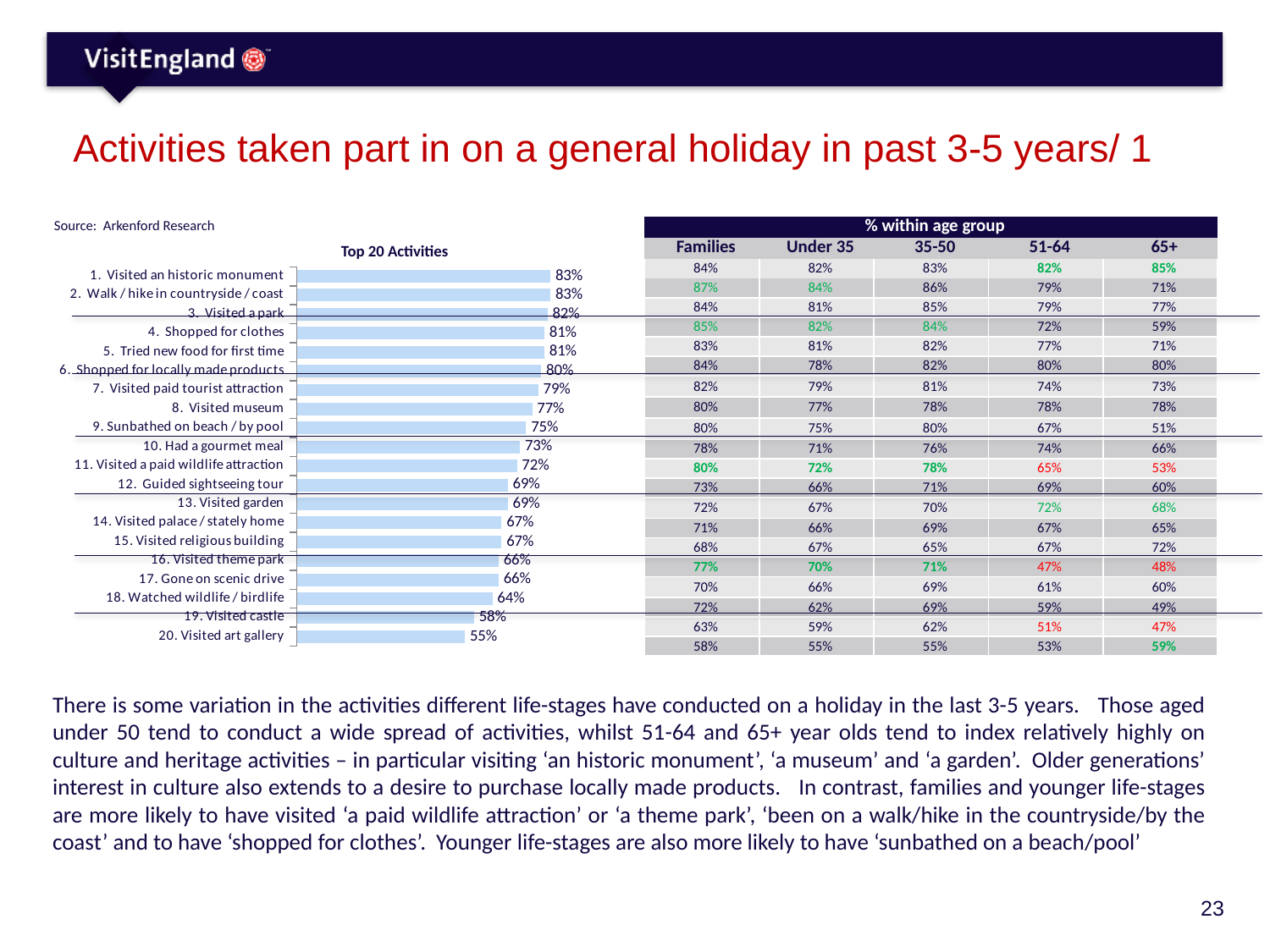
Do the values in the Top 20 Activities chart rise or fall going down the list from activity 1 to activity 20? fall How many activities are plotted in the Top 20 Activities chart? 20 In the Top 20 Activities chart, what is the value for 'Sunbathed on beach / by pool'? 75% In the Top 20 Activities chart, what is the value for 'Shopped for locally made products'? 80% In the Top 20 Activities chart, what is the value for 'Visited museum'? 77% What is the title of the bar chart on the slide? Top 20 Activities In the Top 20 Activities chart, what is the value for 'Visited castle'? 58% Which activity has the lowest value in the Top 20 Activities chart? 20. Visited art gallery In the Top 20 Activities chart, what is the difference between 'Visited an historic monument' and 'Visited art gallery'? 28% In the Top 20 Activities chart, which is larger: 'Visited paid tourist attraction' or 'Watched wildlife / birdlife'? Visited paid tourist attraction In the Top 20 Activities chart, what is the difference between 'Had a gourmet meal' and 'Visited theme park'? 7% What kind of chart is the Top 20 Activities chart? bar chart